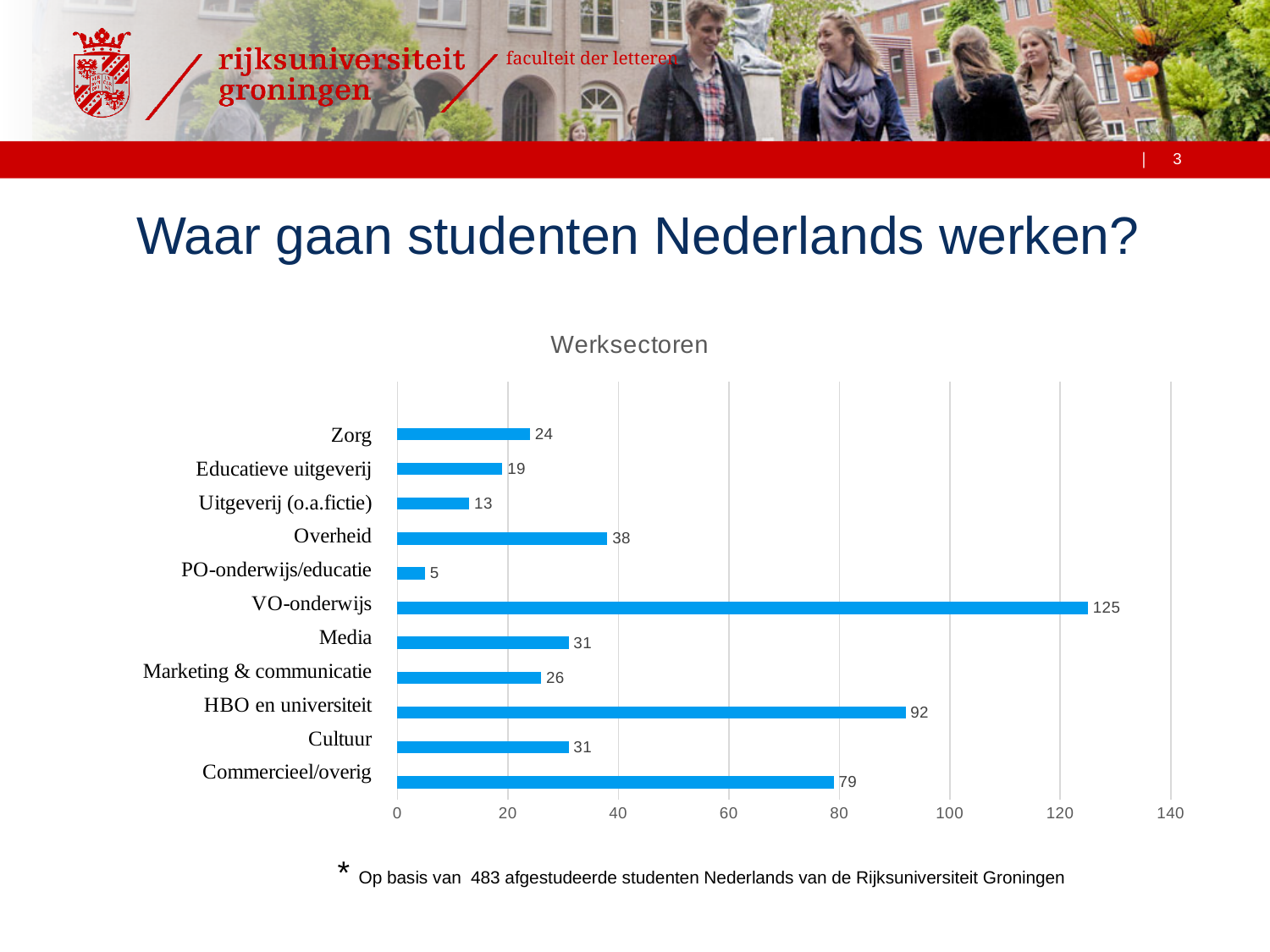
What kind of chart is shown on the slide? bar chart Which category has the highest value? VO-onderwijs What is the difference between the values for VO-onderwijs and HBO en universiteit? 33 Is the value for Commercieel/overig greater or less than 60? greater What is the value for HBO en universiteit? 92 What is the value for VO-onderwijs? 125 How many categories are shown in the chart? 11 Which category has the lowest value? PO-onderwijs/educatie What is the value for Overheid? 38 What is the difference between the values for Media and Marketing & communicatie? 5 Which is larger, the value for Zorg or the value for Educatieve uitgeverij? Zorg What is the title of the chart? Werksectoren